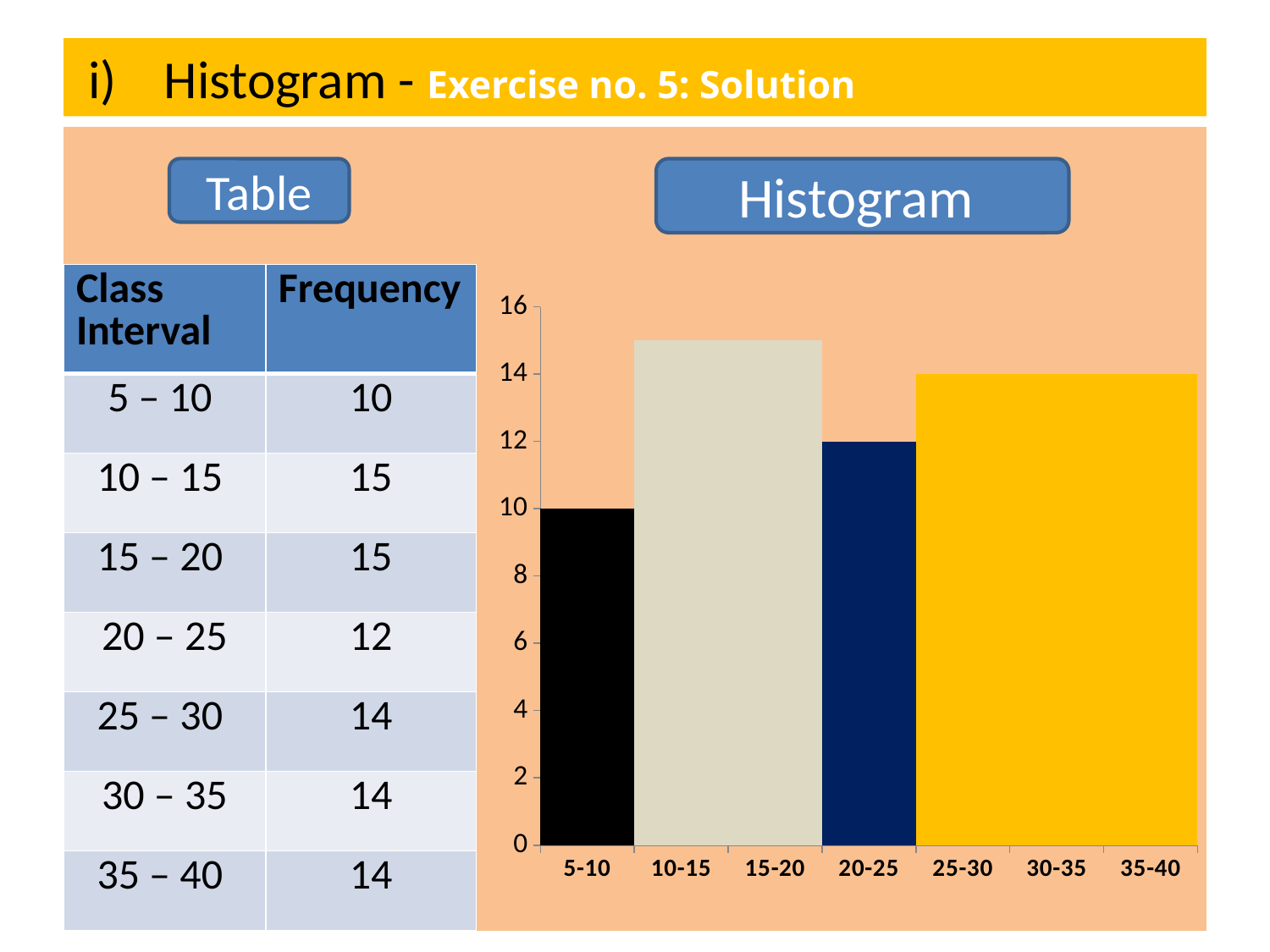
Which class interval has the lowest frequency? 5-10 What is the frequency for the 20-25 class interval? 12 Is the frequency for the 20-25 interval greater or less than 14? less What is the frequency for the 5-10 class interval? 10 Is the frequency for the 15-20 interval greater or less than 14? greater What is the frequency for the 25-30 class interval? 14 What is the difference in frequency between the 20-25 interval and the 5-10 interval? 2 Which has the higher frequency, the 5-10 interval or the 20-25 interval? 20-25 How many class intervals are plotted on the x axis of the histogram? 7 What kind of chart is shown on the slide? bar chart What is the frequency for the 10-15 class interval? 15 What colour is the bar for the 5-10 class interval? black